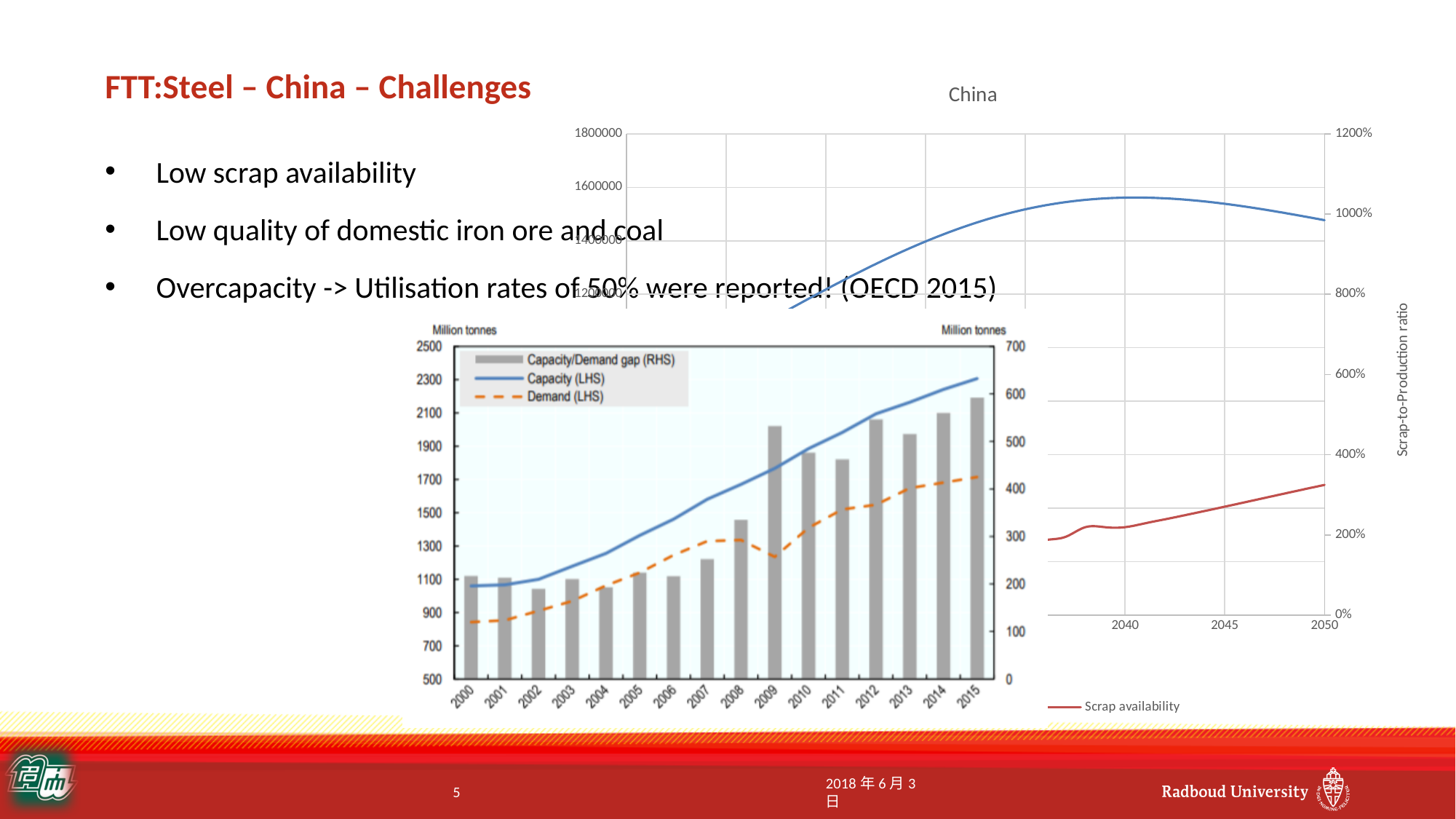
In the chart with the 'Million tonnes' axes, which series is drawn as a dashed orange line? Demand (LHS) In the chart titled 'China', what series does the legend list? Scrap availability In the chart with the 'Million tonnes' axes, is the Capacity/Demand gap bar for 2009 greater or less than 400 on the right-hand axis? greater In the chart with the 'Million tonnes' axes, does the Capacity (LHS) line rise or fall from 2000 to 2015? rise In the chart with the 'Million tonnes' axes, is the Capacity/Demand gap bar for 2012 larger than the bar for 2006? yes In the chart titled 'China', is the Scrap availability value at 2050 greater or less than 200%? greater In the chart with the 'Million tonnes' axes, how many years are shown on the x axis? 16 In the chart with the 'Million tonnes' axes, which year has the highest Capacity/Demand gap bar? 2015 In the chart with the 'Million tonnes' axes, is the Capacity/Demand gap bar for 2015 greater or less than 500 on the right-hand axis? greater In the chart with the 'Million tonnes' axes, which year has the lowest Capacity/Demand gap bar? 2002 In the chart titled 'China', does the Scrap availability line rise or fall from 2040 to 2050? rise In the chart with the 'Million tonnes' axes, how many series does the legend list? 3